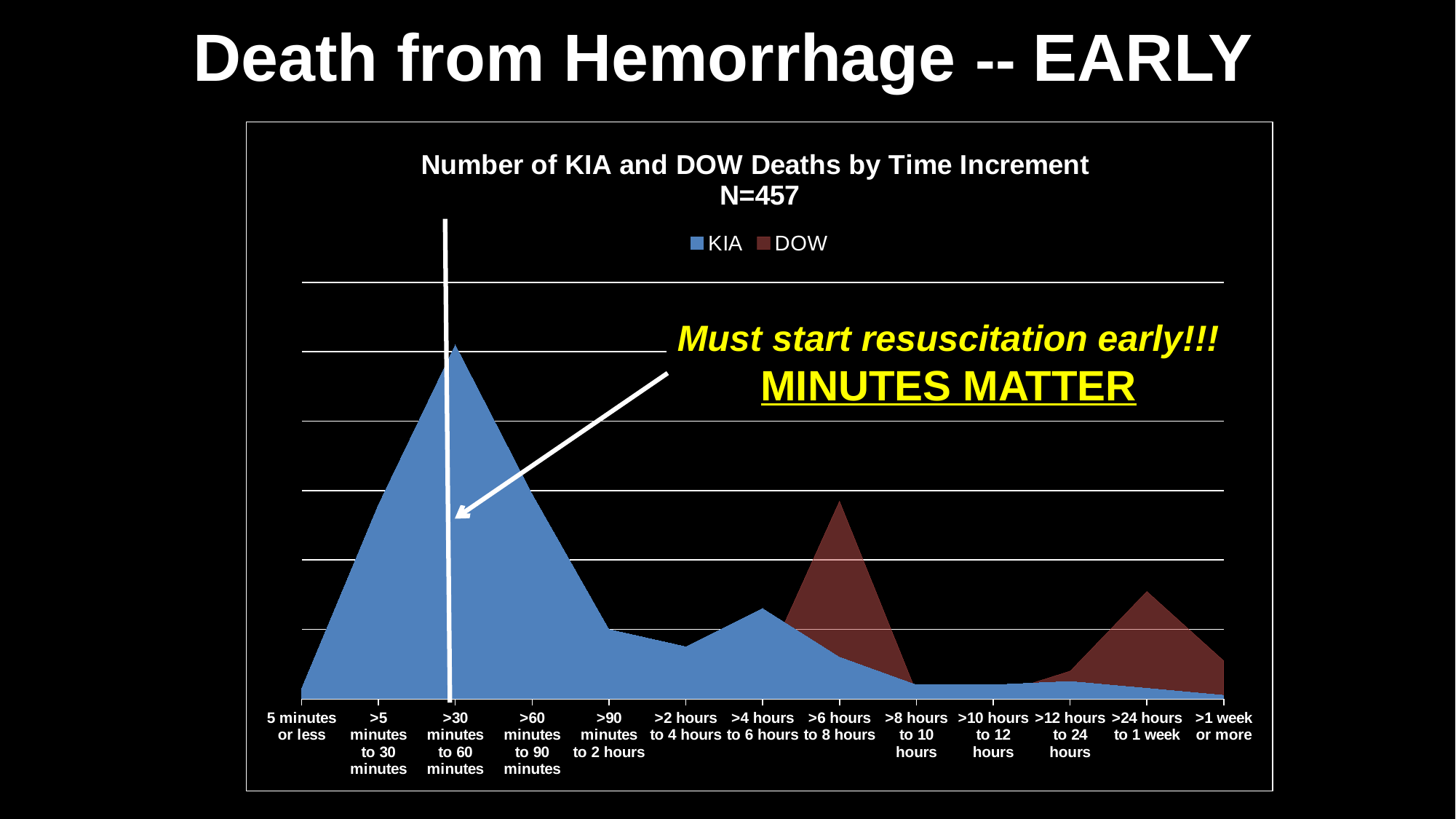
Do the KIA values rise or fall from 5 minutes or less to >30 minutes to 60 minutes? Rise For the DOW series, which is larger: the value at >6 hours to 8 hours or the value at >24 hours to 1 week? >6 hours to 8 hours For the KIA series, which is larger: the value at >2 hours to 4 hours or the value at >4 hours to 6 hours? >4 hours to 6 hours In which time increment does the KIA series reach its highest value? >30 minutes to 60 minutes How many series does the legend list? 2 What are the two series named in the legend? KIA and DOW How many time increment categories are shown on the x axis? 13 What is the title of the chart? Number of KIA and DOW Deaths by Time Increment N=457 Do the KIA values rise or fall from >30 minutes to 60 minutes through >2 hours to 4 hours? Fall In which time increment does the DOW series reach its highest value? >6 hours to 8 hours Which is larger: the peak of the KIA series or the peak of the DOW series? KIA What kind of chart is shown on the slide? Area chart